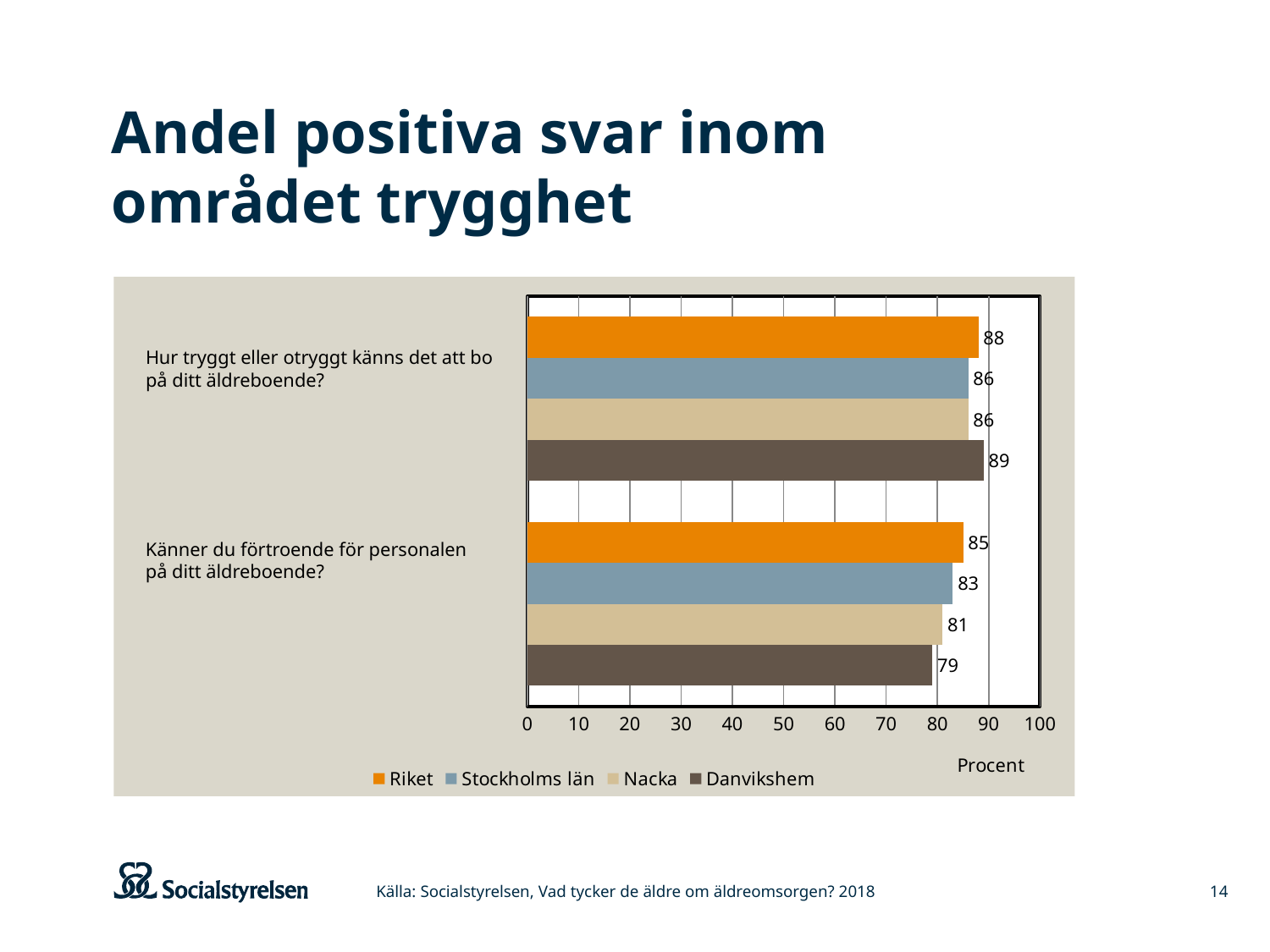
What is the value for Nacka on the question "Känner du förtroende för personalen på ditt äldreboende?"? 81 Which series has the highest value on the question "Hur tryggt eller otryggt känns det att bo på ditt äldreboende?"? Danvikshem What is the value for Riket on the question "Känner du förtroende för personalen på ditt äldreboende?"? 85 What colour are the bars for Riket? Orange What is the label of the x axis? Procent How many series does the legend list? 4 How many questions (categories) are shown on the chart? 2 What is the value for Danvikshem on the question "Hur tryggt eller otryggt känns det att bo på ditt äldreboende?"? 89 Which is larger on the question "Känner du förtroende för personalen på ditt äldreboende?": Stockholms län or Nacka? Stockholms län Which series has the lowest value on the question "Känner du förtroende för personalen på ditt äldreboende?"? Danvikshem What is the difference between the Riket and Danvikshem values on the question "Känner du förtroende för personalen på ditt äldreboende?"? 6 What kind of chart is shown on the slide? Bar chart